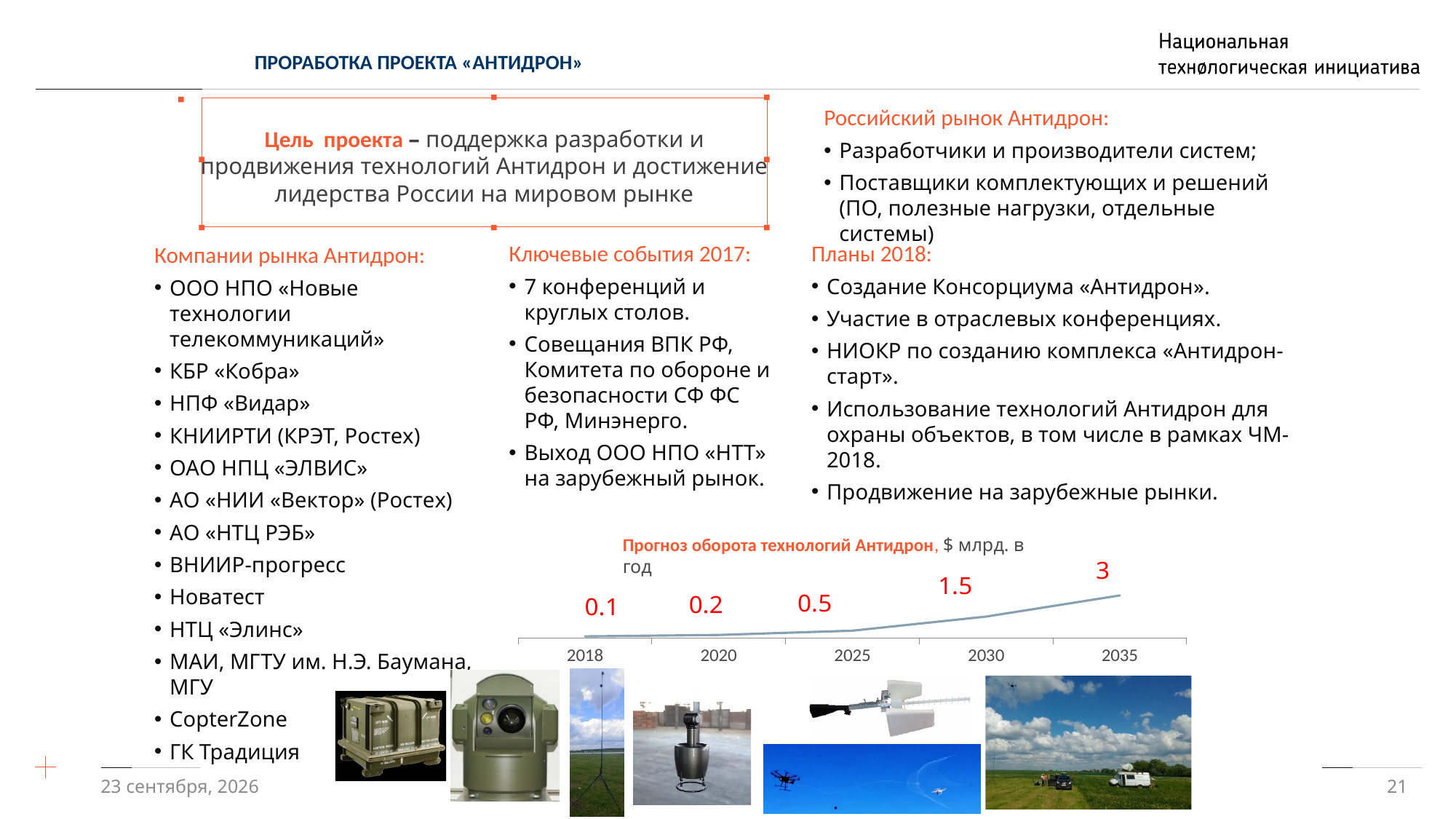
In the chart 'Прогноз оборота технологий Антидрон', what is the difference between the values for 2025 and 2020? 0.3 Do the values in the chart 'Прогноз оборота технологий Антидрон' rise or fall from 2018 to 2035? rise What is the forecast value for 2030 in the chart 'Прогноз оборота технологий Антидрон'? 1.5 How many years are plotted on the x axis of the chart 'Прогноз оборота технологий Антидрон'? 5 What is the forecast value for 2018 in the chart 'Прогноз оборота технологий Антидрон'? 0.1 In the chart 'Прогноз оборота технологий Антидрон', what is the difference between the values for 2035 and 2030? 1.5 Which year has the lowest value in the chart 'Прогноз оборота технологий Антидрон'? 2018 In the chart 'Прогноз оборота технологий Антидрон', which is larger: the value for 2020 or the value for 2030? 2030 What is the forecast value for 2025 in the chart 'Прогноз оборота технологий Антидрон'? 0.5 Which year has the highest value in the chart 'Прогноз оборота технологий Антидрон'? 2035 What kind of chart is 'Прогноз оборота технологий Антидрон'? line chart What is the forecast value for 2035 in the chart 'Прогноз оборота технологий Антидрон'? 3